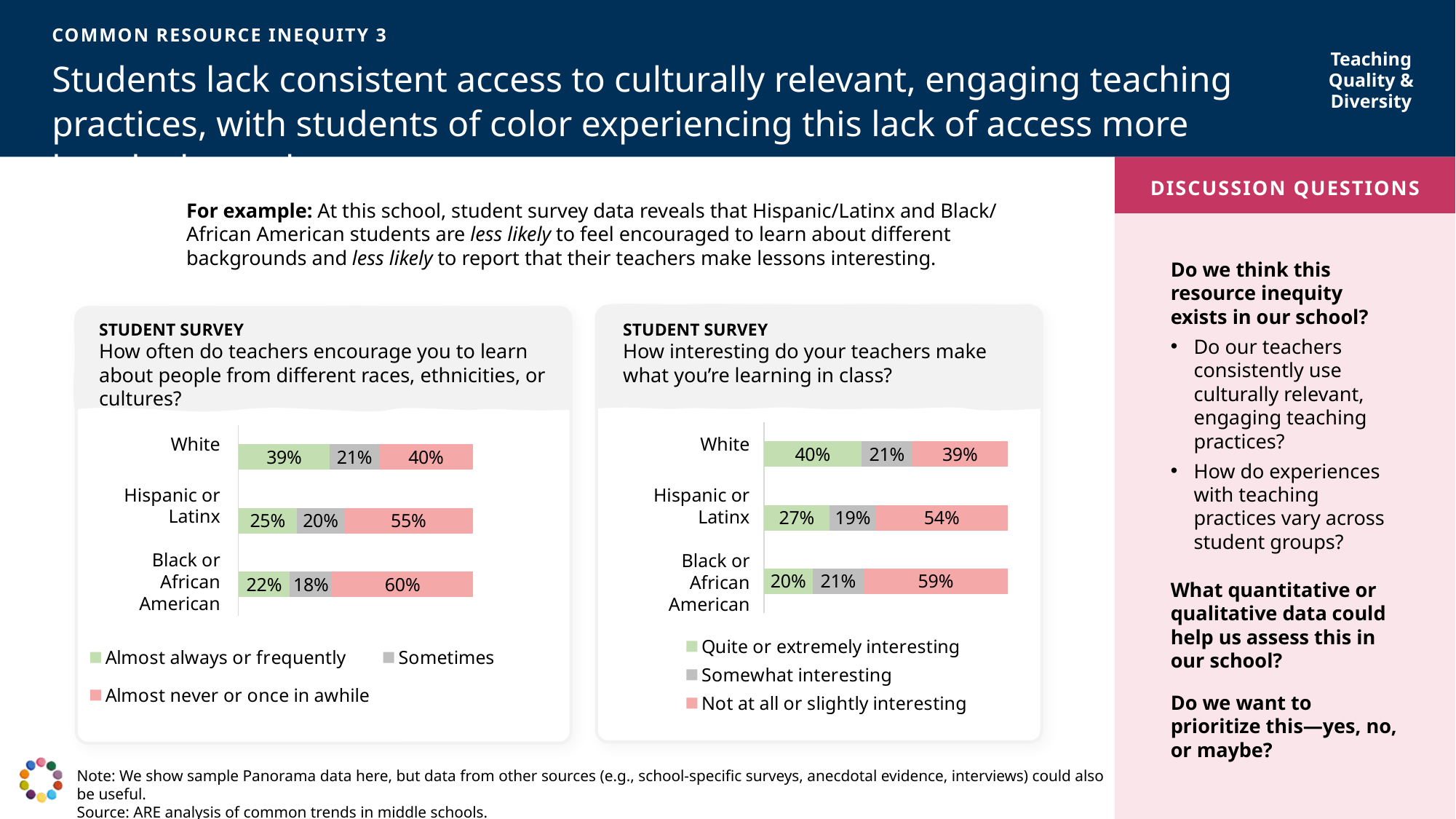
In the left chart (how often teachers encourage learning about different races, ethnicities, or cultures), what percentage of Black or African American students answered "Almost never or once in awhile"? 60% In the right chart (how interesting teachers make what you're learning), what percentage of Black or African American students answered "Quite or extremely interesting"? 20% In the left chart (how often teachers encourage learning about different races, ethnicities, or cultures), which student group has the highest "Almost never or once in awhile" percentage? Black or African American In the left chart (how often teachers encourage learning about different races, ethnicities, or cultures), what is the difference between the "Almost never or once in awhile" percentages for Black or African American students and White students? 20% How many student groups are shown in the left chart (how often teachers encourage learning about different races, ethnicities, or cultures)? 3 In the left chart (how often teachers encourage learning about different races, ethnicities, or cultures), what percentage of White students answered "Almost always or frequently"? 39% In the right chart (how interesting teachers make what you're learning), what is the difference between the "Quite or extremely interesting" percentages for White students and Hispanic or Latinx students? 13% In the right chart (how interesting teachers make what you're learning), which student group has the lowest "Quite or extremely interesting" percentage? Black or African American What type of chart is the left chart (how often teachers encourage learning about different races, ethnicities, or cultures)? Stacked bar chart How many series does the legend of the right chart (how interesting teachers make what you're learning) list? 3 In the right chart (how interesting teachers make what you're learning), which is larger: the "Not at all or slightly interesting" percentage for White students or for Hispanic or Latinx students? Hispanic or Latinx In the right chart (how interesting teachers make what you're learning), what percentage of Hispanic or Latinx students answered "Not at all or slightly interesting"? 54%